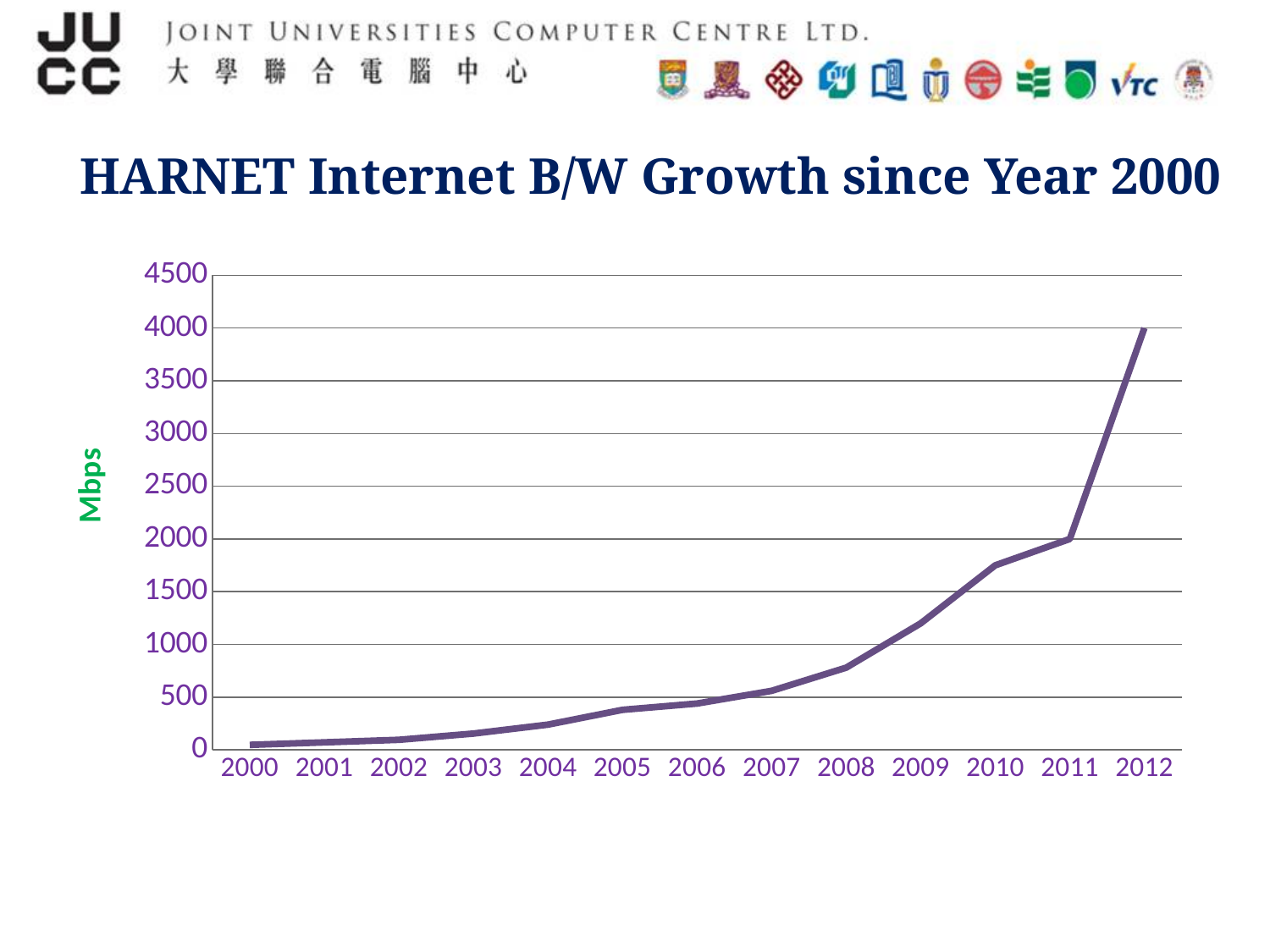
Which year has the lowest bandwidth value? 2000 How many years are plotted along the x axis? 13 Which year has the larger value, 2008 or 2010? 2010 What kind of chart is shown on the slide? line chart What is the title of the chart? HARNET Internet B/W Growth since Year 2000 Is the value for 2005 greater or less than 500? less Do the values rise or fall from 2000 to 2012? rise Is the value for 2008 greater or less than 1000? less What unit is shown on the y-axis label? Mbps Which year has the highest bandwidth value? 2012 What is the bandwidth value for 2012 in Mbps? 4000 Is the value for 2010 greater or less than 1500? greater